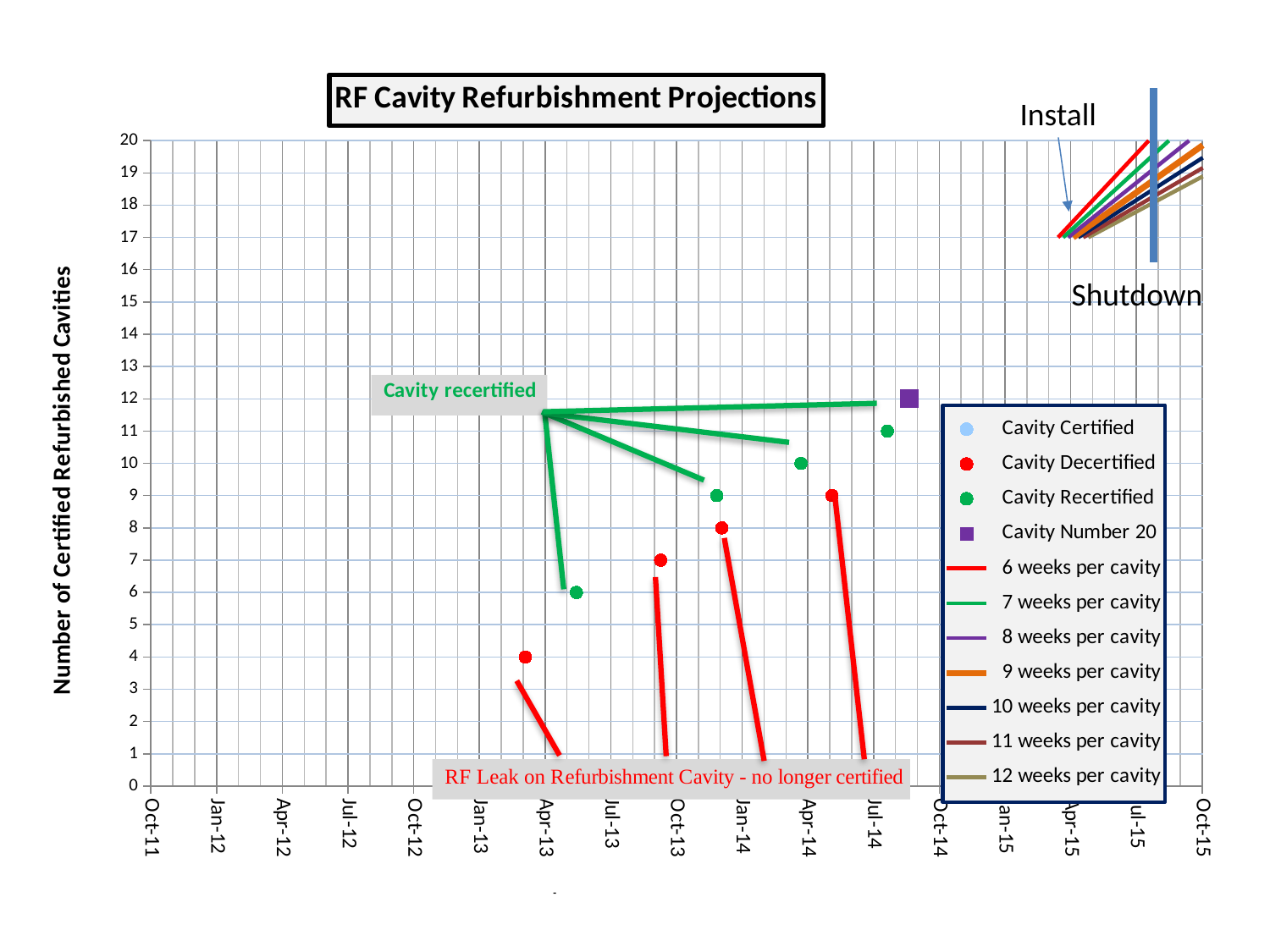
How many entries does the chart's legend list? 11 How many Cavity Recertified (green) points are plotted on the chart? 4 What is the highest value reached by a Cavity Decertified point? 9 How many Cavity Decertified (red) points are plotted on the chart? 4 What is the highest value reached by a Cavity Recertified point? 11 At what number of certified refurbished cavities is the Cavity Number 20 marker plotted? 12 What is the title of the chart? RF Cavity Refurbishment Projections Do the Cavity Recertified points rise or fall over time along the x axis? rise What is the label on the vertical axis of the chart? Number of Certified Refurbished Cavities What is the difference between the highest and lowest Cavity Recertified values? 5 What is the lowest value of a Cavity Recertified point? 6 What is the lowest value of a Cavity Decertified point? 4